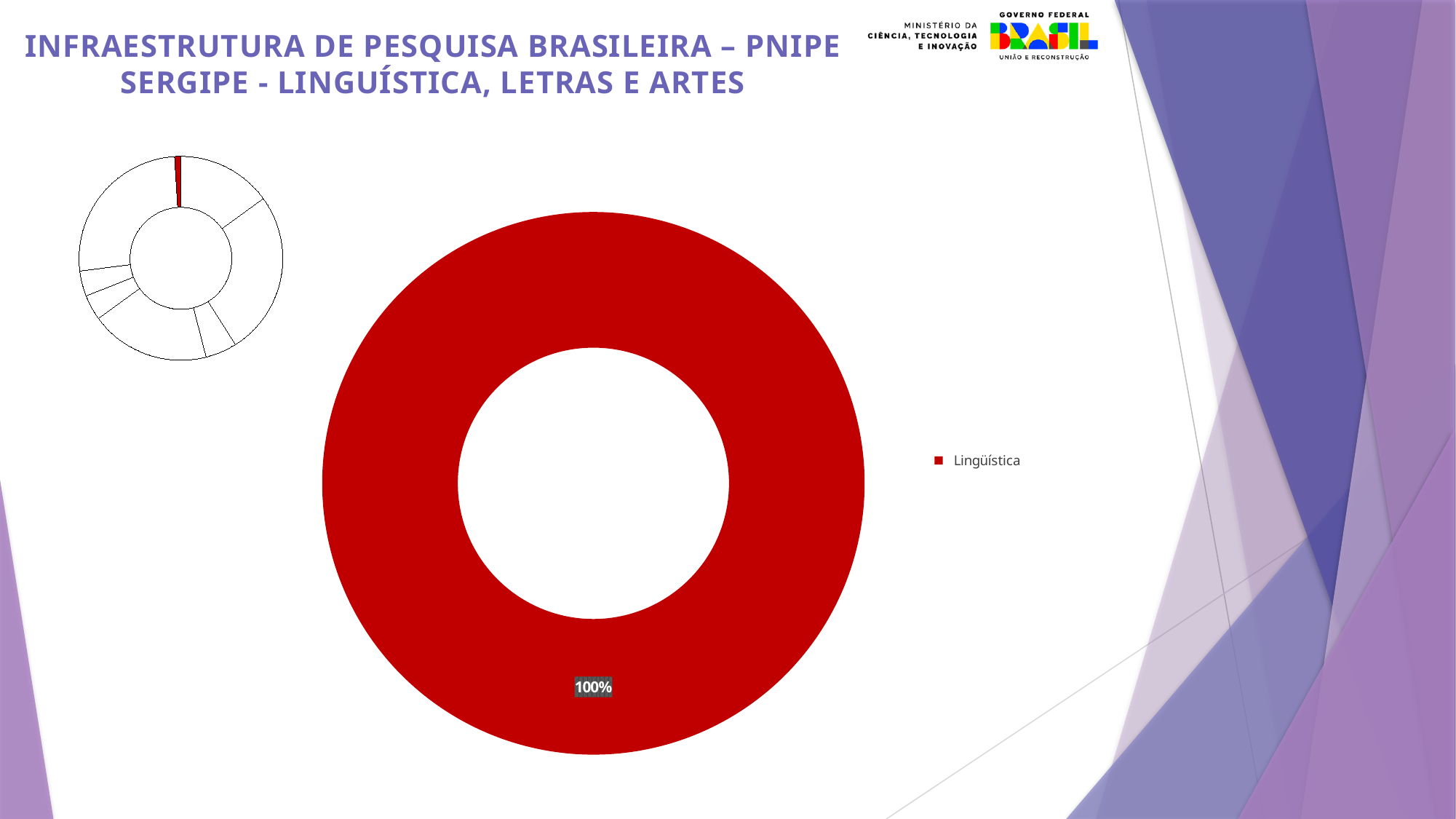
What kind of chart is the large chart in the centre of the slide? Doughnut chart What is the name of the only category shown in the legend of the large doughnut chart? Lingüística How many slices does the large doughnut chart contain? 1 What share of the large doughnut chart does the Lingüística slice take up? 100% What colour is the Lingüística slice in the large doughnut chart? Red In the large doughnut chart, what percentage is shown for Lingüística? 100% How many entries does the legend of the large doughnut chart list? 1